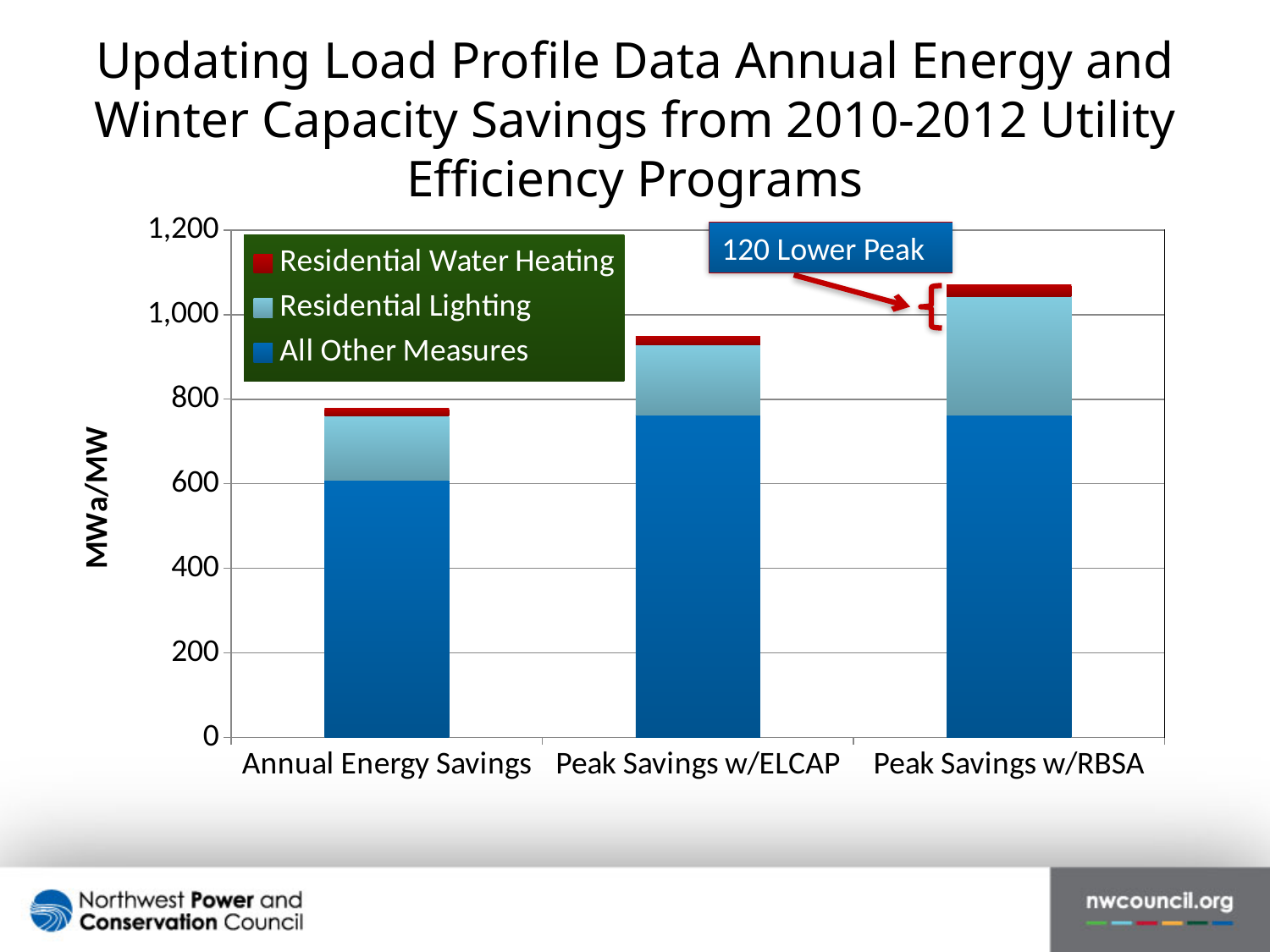
What kind of chart is shown on the slide? Stacked bar chart How many series does the chart's legend list? 3 Which category has the lowest total bar? Annual Energy Savings How many categories are shown on the x axis of the chart? 3 Is the total bar for Annual Energy Savings greater or less than 600? greater Is the total bar for Peak Savings w/RBSA greater or less than 1,000? greater What does the callout box above the chart say? 120 Lower Peak Which category has the highest total bar? Peak Savings w/RBSA Is the total bar for Peak Savings w/ELCAP greater or less than 1,000? less Which total is larger: Peak Savings w/ELCAP or Peak Savings w/RBSA? Peak Savings w/RBSA What is the label on the chart's y axis? MWa/MW